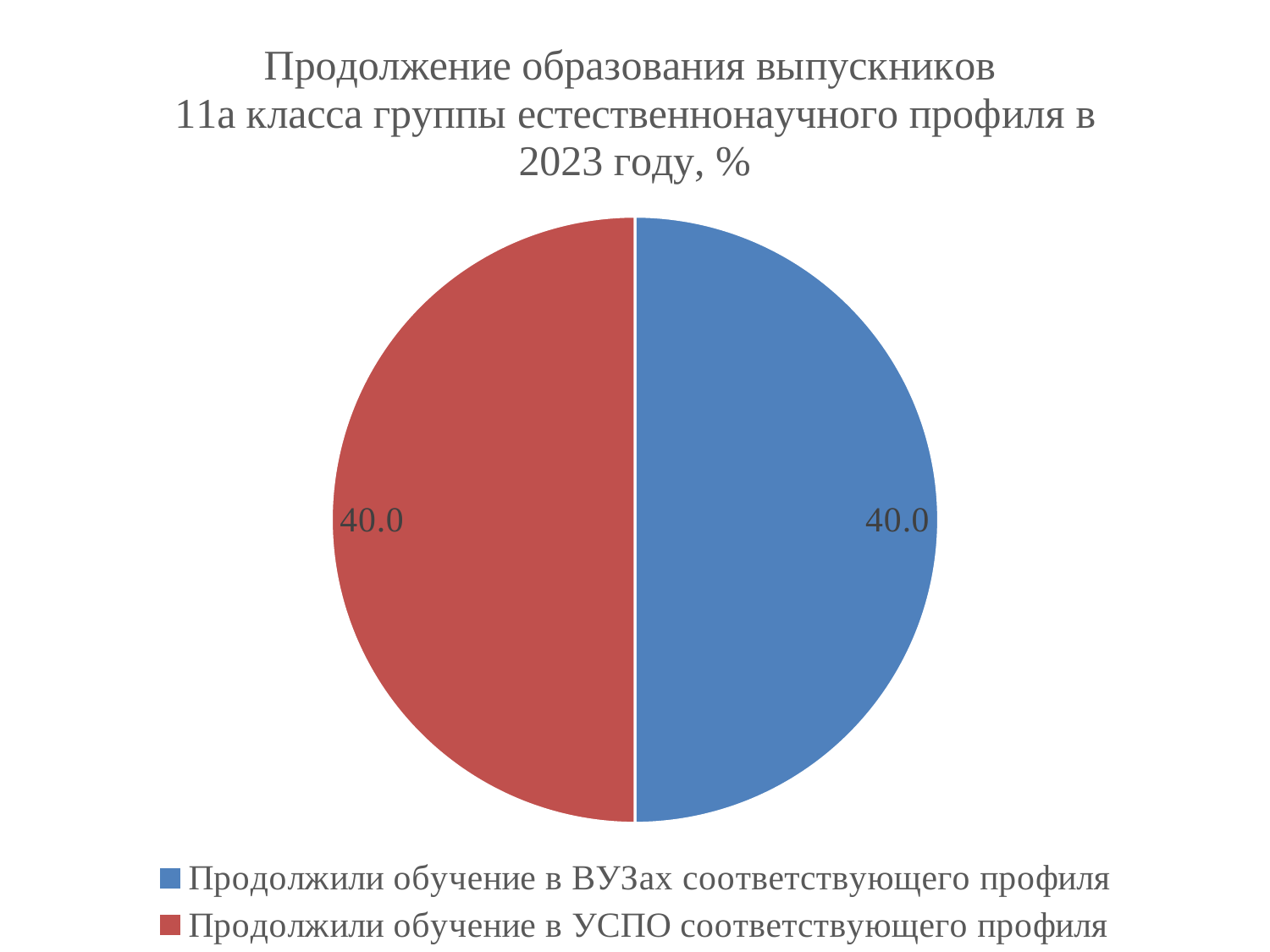
What kind of chart is shown on the slide? Pie chart What value is shown for the slice 'Продолжили обучение в УСПО соответствующего профиля'? 40.0 What value is shown for the slice 'Продолжили обучение в ВУЗах соответствующего профиля'? 40.0 Are the values for the two slices equal or different? Equal How many entries does the legend list? 2 What colour is the slice for 'Продолжили обучение в ВУЗах соответствующего профиля'? Blue What is the sum of the two values printed on the pie chart? 80.0 What is the difference between the value for 'Продолжили обучение в ВУЗах соответствующего профиля' and the value for 'Продолжили обучение в УСПО соответствующего профиля'? 0.0 Which year is mentioned in the chart title? 2023 How many slices does the pie chart have? 2